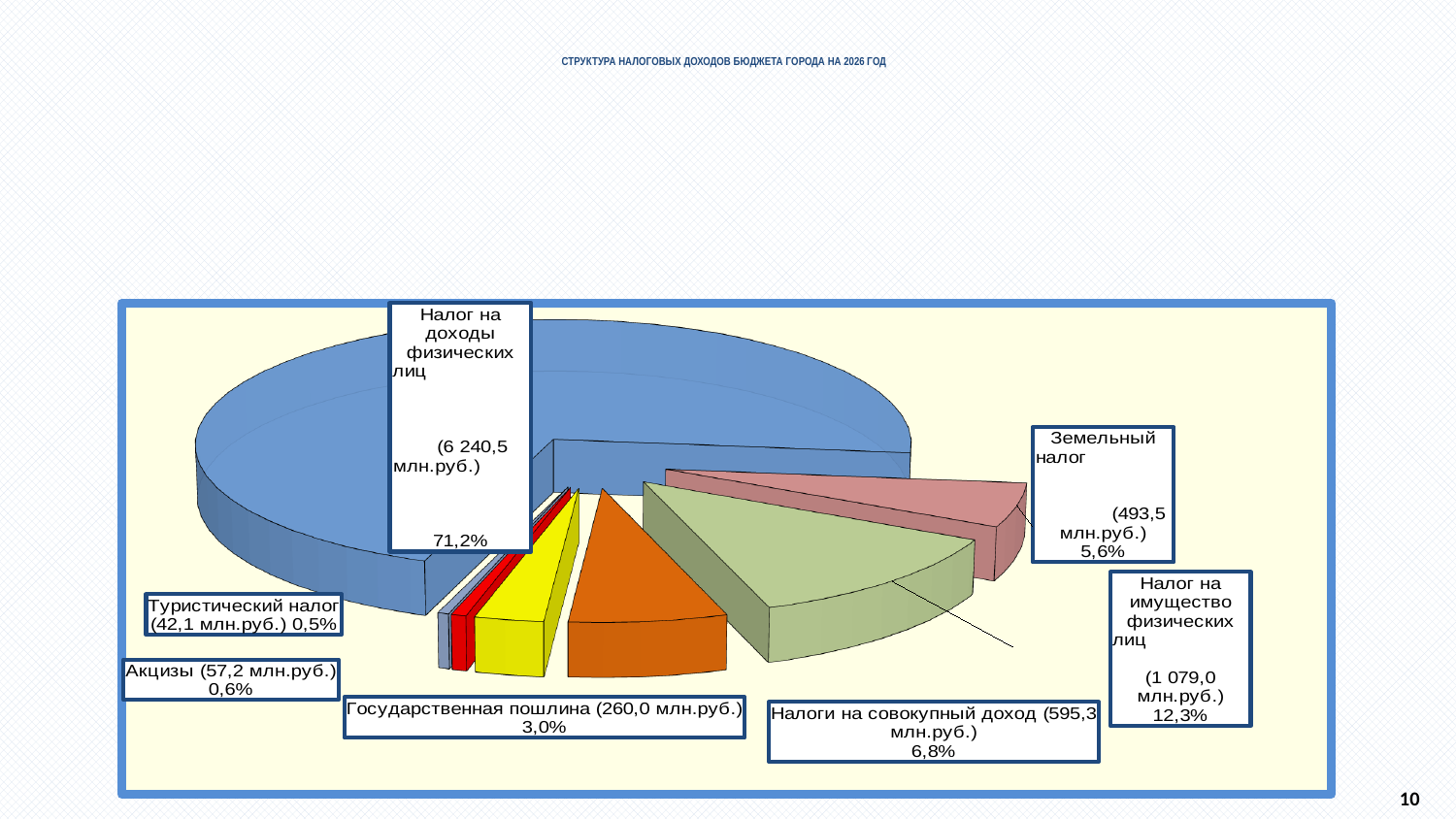
What is the difference in percentage points between the share for Налог на имущество физических лиц and the share for Земельный налог? 6,7% What kind of chart is shown on the slide? pie chart How many slices does the pie chart have? 7 Which category has the smallest share of the pie? Туристический налог Which category has the largest share of the pie? Налог на доходы физических лиц What percentage is shown for Налоги на совокупный доход? 6,8% What is the title of the chart? СТРУКТУРА НАЛОГОВЫХ ДОХОДОВ БЮДЖЕТА ГОРОДА НА 2026 ГОД What is the value shown for Государственная пошлина? 260,0 млн.руб. What share of the pie does Налог на доходы физических лиц represent? 71,2% What is the value shown for Земельный налог? 493,5 млн.руб. What is the value shown for Налог на имущество физических лиц? 1 079,0 млн.руб. Which is larger: the share for Земельный налог or the share for Налоги на совокупный доход? Налоги на совокупный доход